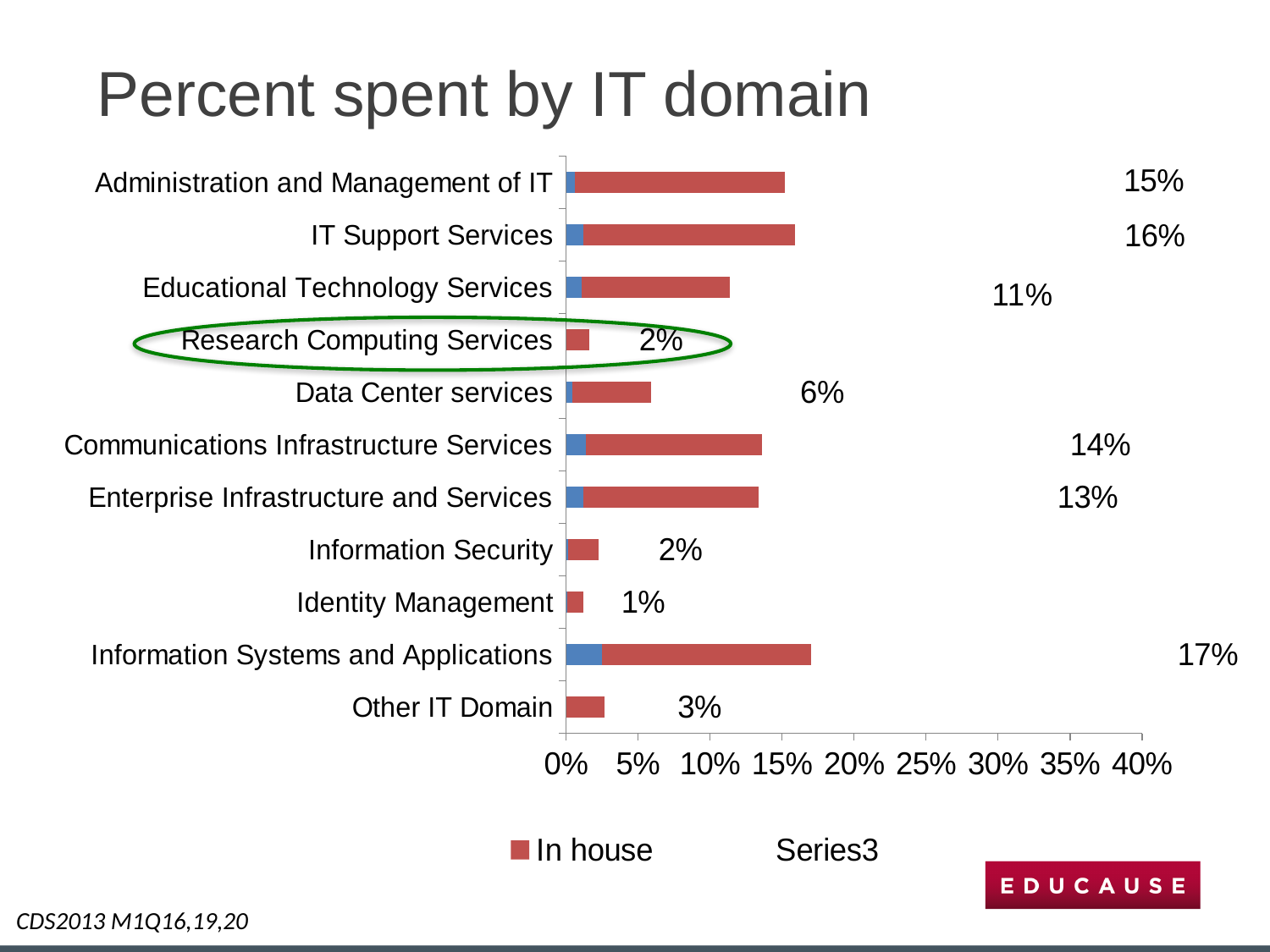
What percentage is labelled for Research Computing Services? 2% Which has a larger labelled percentage, IT Support Services or Educational Technology Services? IT Support Services What percentage is labelled for Administration and Management of IT? 15% What percentage is labelled for Data Center services? 6% What kind of chart is shown on the slide? bar chart What percentage is labelled for Information Systems and Applications? 17% How many series does the legend list? 2 Which IT domain has the lowest labelled percentage? Identity Management How many IT domain categories are shown on the chart? 11 What is the title of the chart? Percent spent by IT domain What is the difference between the labelled percentages for Information Systems and Applications and Identity Management? 16 percentage points Which IT domain has the highest labelled percentage? Information Systems and Applications